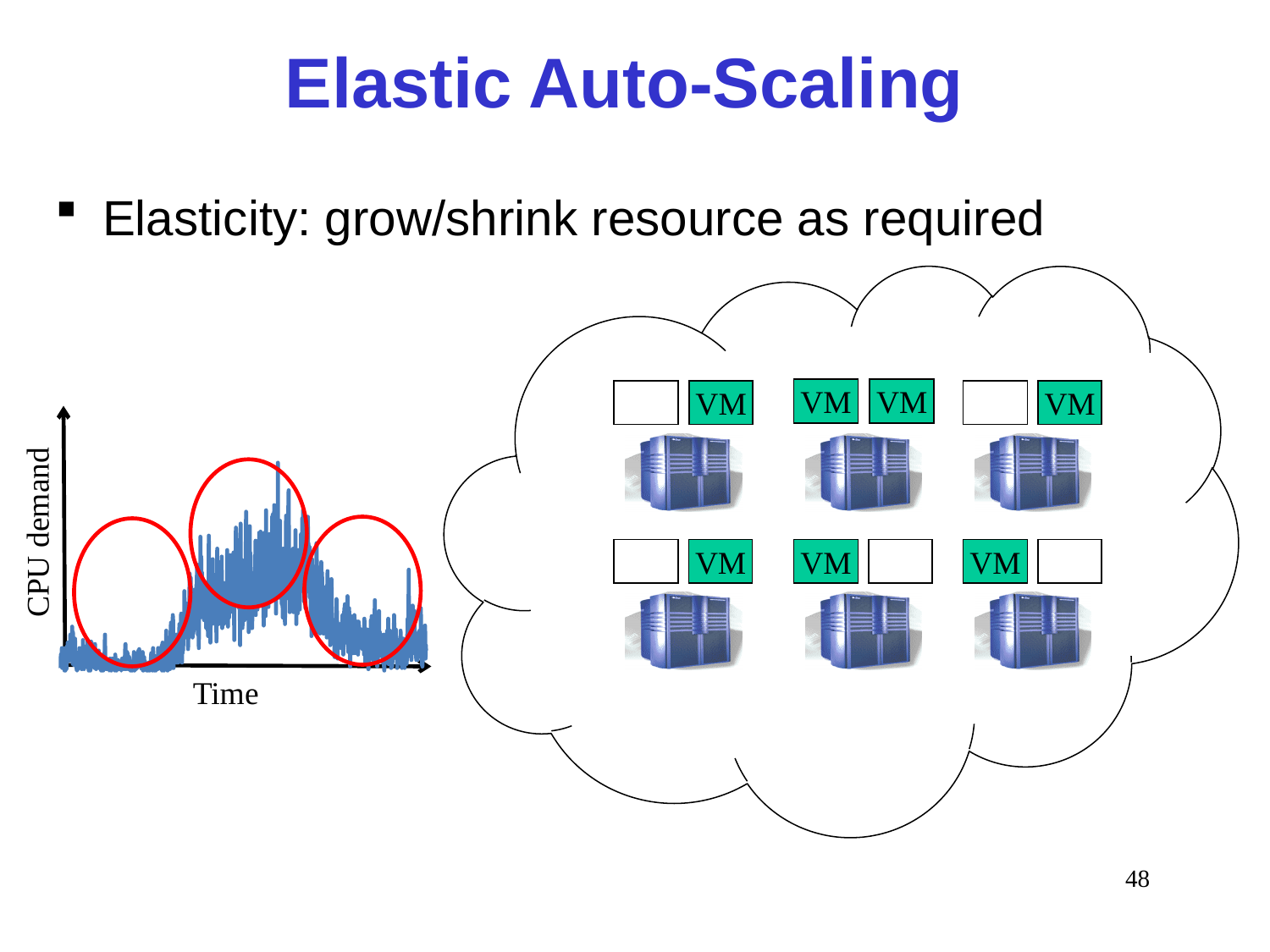
Does CPU demand rise or fall from the first circled region to the middle circled region? rise What kind of chart is shown on the left of the slide? line chart What is the label on the vertical axis of the chart? CPU demand What is the label on the horizontal axis of the chart? Time Which of the three circled regions shows the highest CPU demand? the middle one Is CPU demand in the first circled region higher or lower than in the middle circled region? lower Does CPU demand rise or fall from the middle circled region to the last circled region? fall